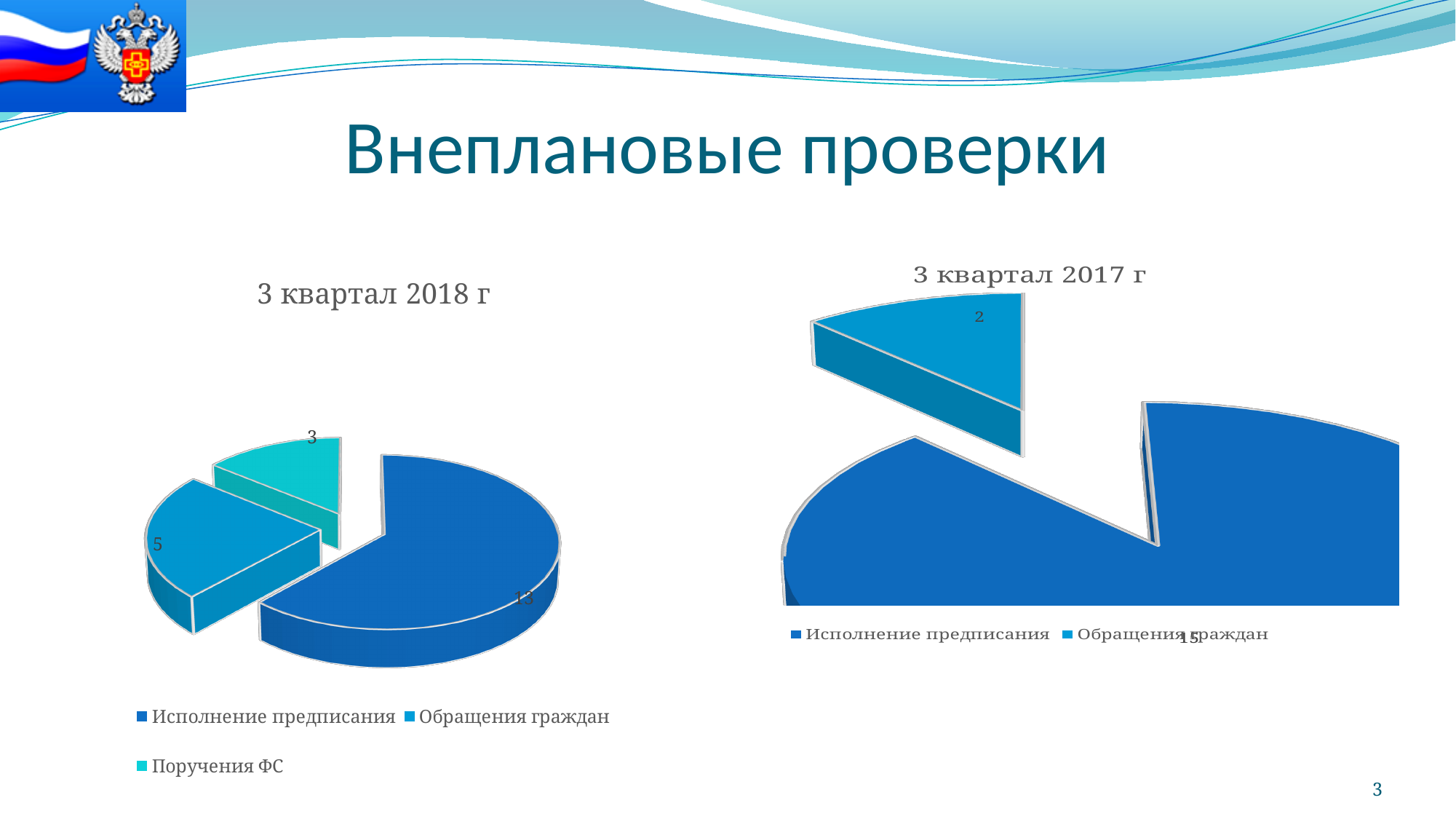
In the chart titled "3 квартал 2017 г", what is the value for Исполнение предписания? 15 In the chart titled "3 квартал 2018 г", what is the value for Исполнение предписания? 13 In the chart titled "3 квартал 2018 г", what is the value for Обращения граждан? 5 In the chart titled "3 квартал 2018 г", what is the difference between Исполнение предписания and Обращения граждан? 8 What type of chart is the chart titled "3 квартал 2017 г"? Pie chart In the chart titled "3 квартал 2017 г", what is the difference between Исполнение предписания and Обращения граждан? 13 In the chart titled "3 квартал 2018 г", which category has the smallest slice? Поручения ФС In the chart titled "3 квартал 2018 г", how many categories does the legend list? 3 In the chart titled "3 квартал 2017 г", how many slices does the pie have? 2 In the chart titled "3 квартал 2018 г", which category has the largest slice? Исполнение предписания In the chart titled "3 квартал 2018 г", what is the value for Поручения ФС? 3 In the chart titled "3 квартал 2017 г", what is the value for Обращения граждан? 2